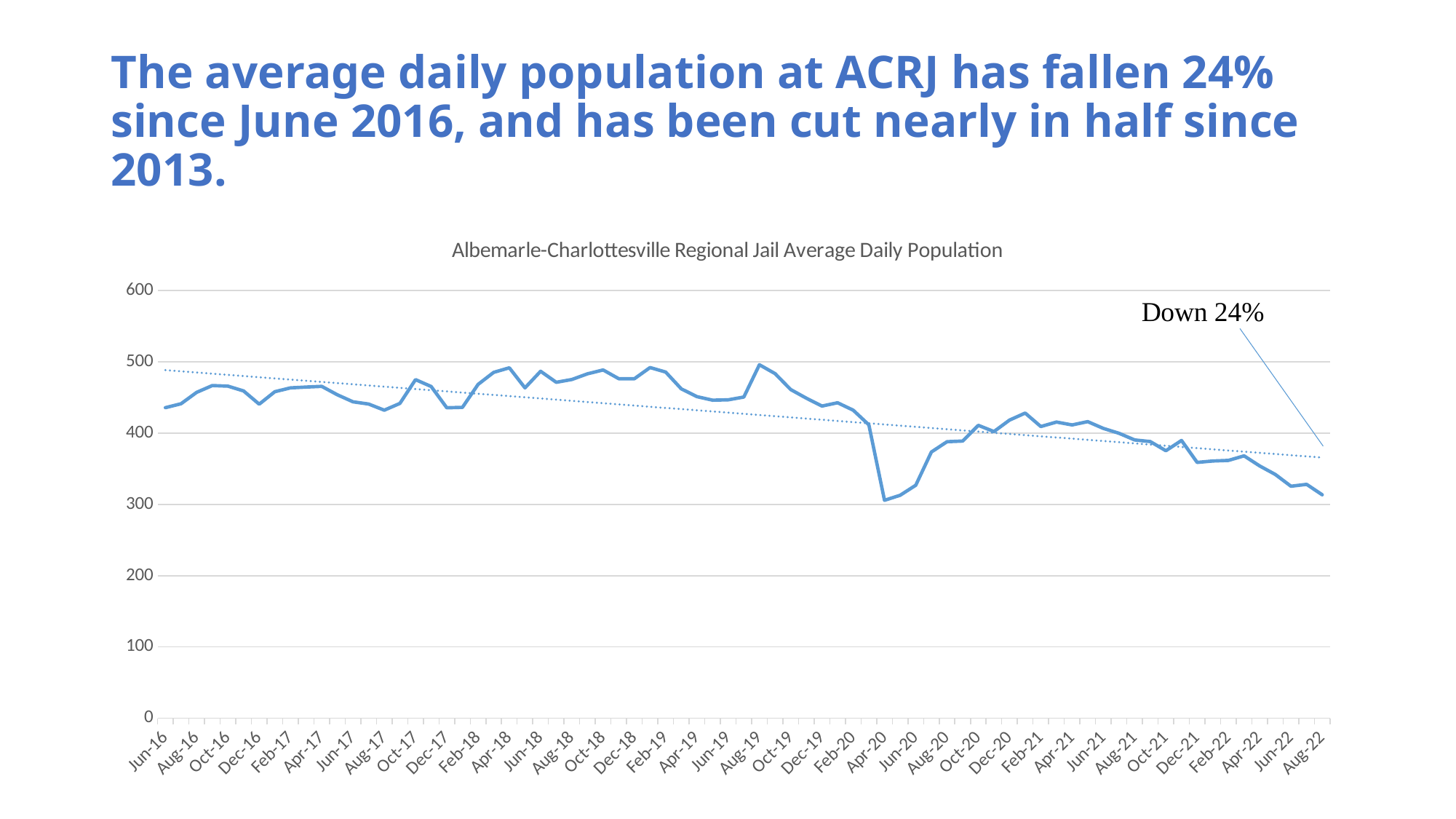
What is the first month label on the x axis? Jun-16 Is the value for Aug-22 greater or less than 400? less Is the value for Jun-16 greater or less than 400? greater What kind of chart is shown on the slide? line chart Which is larger, the value for Jun-16 or the value for Aug-22? Jun-16 What does the annotation on the right side of the chart say? Down 24% Overall, does the average daily population rise or fall from Jun-16 to Aug-22? fall Is the value for Apr-20 greater or less than 400? less Which is larger, the value for Aug-19 or the value for Apr-20? Aug-19 What is the title of the chart? Albemarle-Charlottesville Regional Jail Average Daily Population